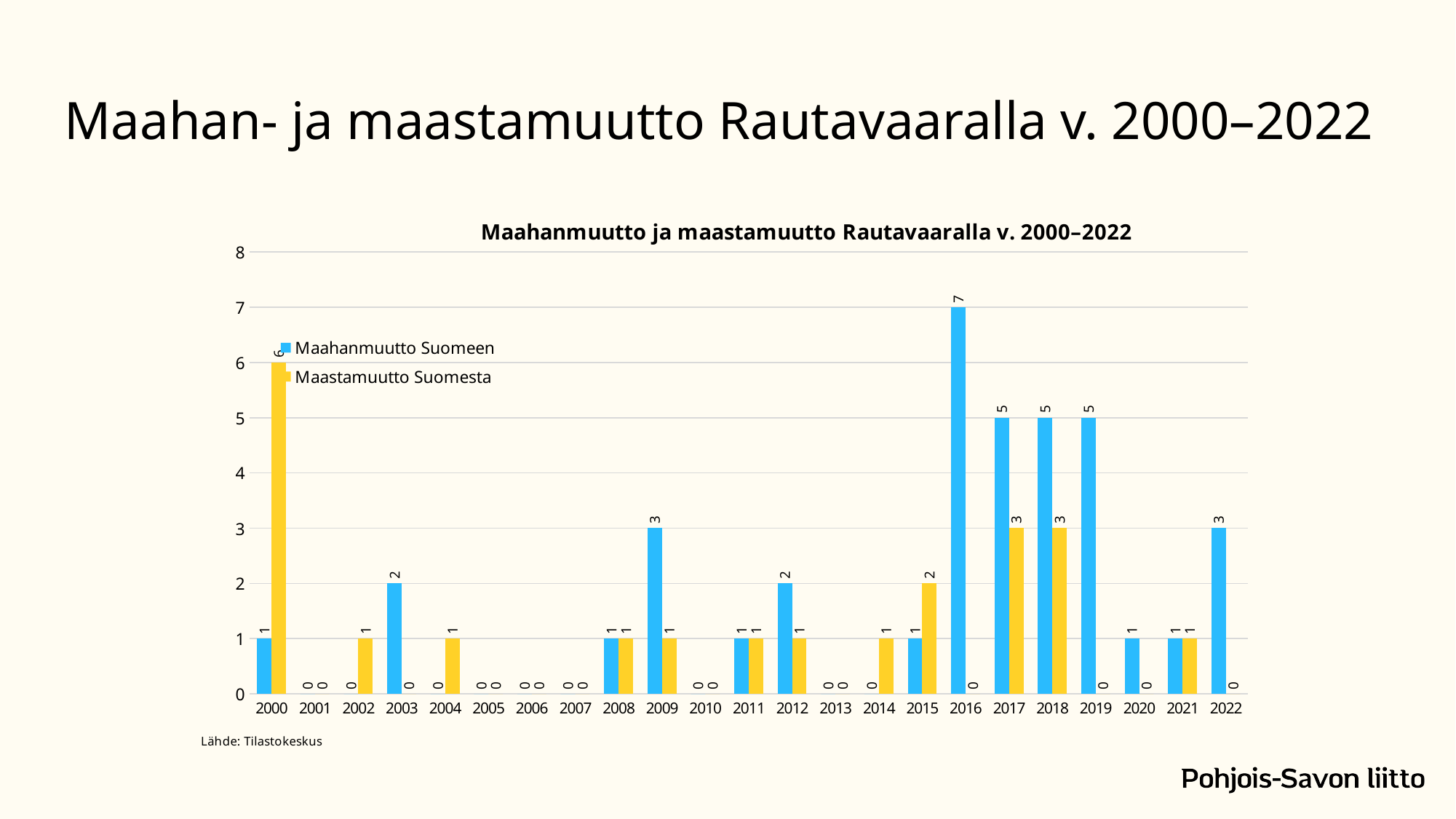
What is the value of Maahanmuutto Suomeen in 2016? 7 In which year is Maastamuutto Suomesta highest? 2000 Which colour represents Maastamuutto Suomesta in the chart? yellow Which is larger in 2015, Maahanmuutto Suomeen or Maastamuutto Suomesta? Maastamuutto Suomesta What type of chart is shown on the slide? bar chart How many series does the legend list? 2 What is the value of Maastamuutto Suomesta in 2000? 6 What is the difference between Maahanmuutto Suomeen and Maastamuutto Suomesta in 2017? 2 How many years are shown on the x axis? 23 In which year is Maahanmuutto Suomeen highest? 2016 What is the value of Maastamuutto Suomesta in 2018? 3 What is the value of Maahanmuutto Suomeen in 2022? 3